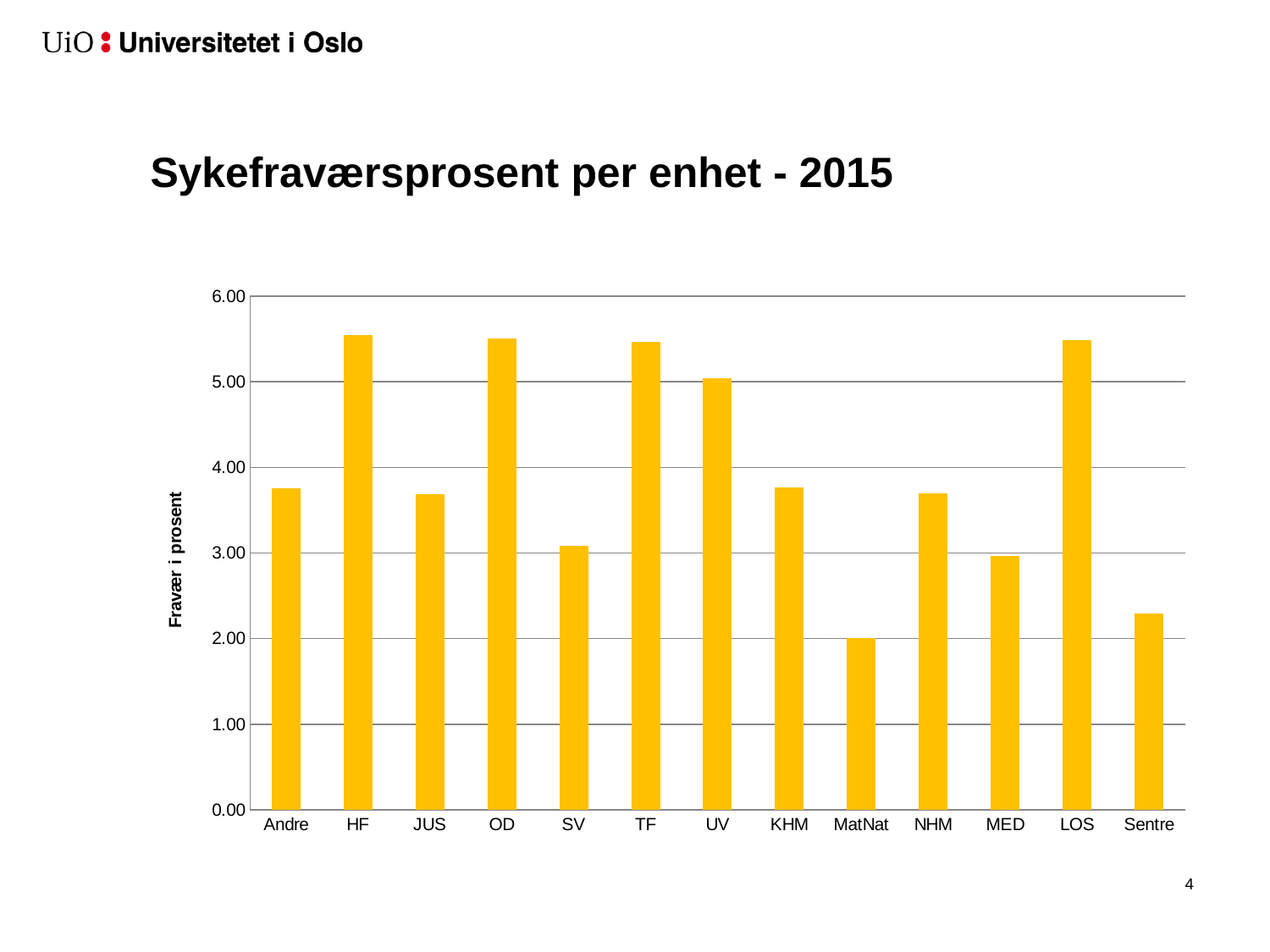
How many units (categories) are shown on the x axis of the chart? 13 Which has the larger value, UV or KHM? UV Is the value for JUS greater or less than 3.00? greater Is the value for HF greater or less than 5.00? greater Is the value for Andre greater or less than 4.00? less What is the title of the chart on the slide? Sykefraværsprosent per enhet - 2015 Which unit has the lowest sick leave percentage in the chart? MatNat Which has the larger value, HF or SV? HF What kind of chart is shown on the slide? bar chart What is the label on the vertical axis of the chart? Fravær i prosent